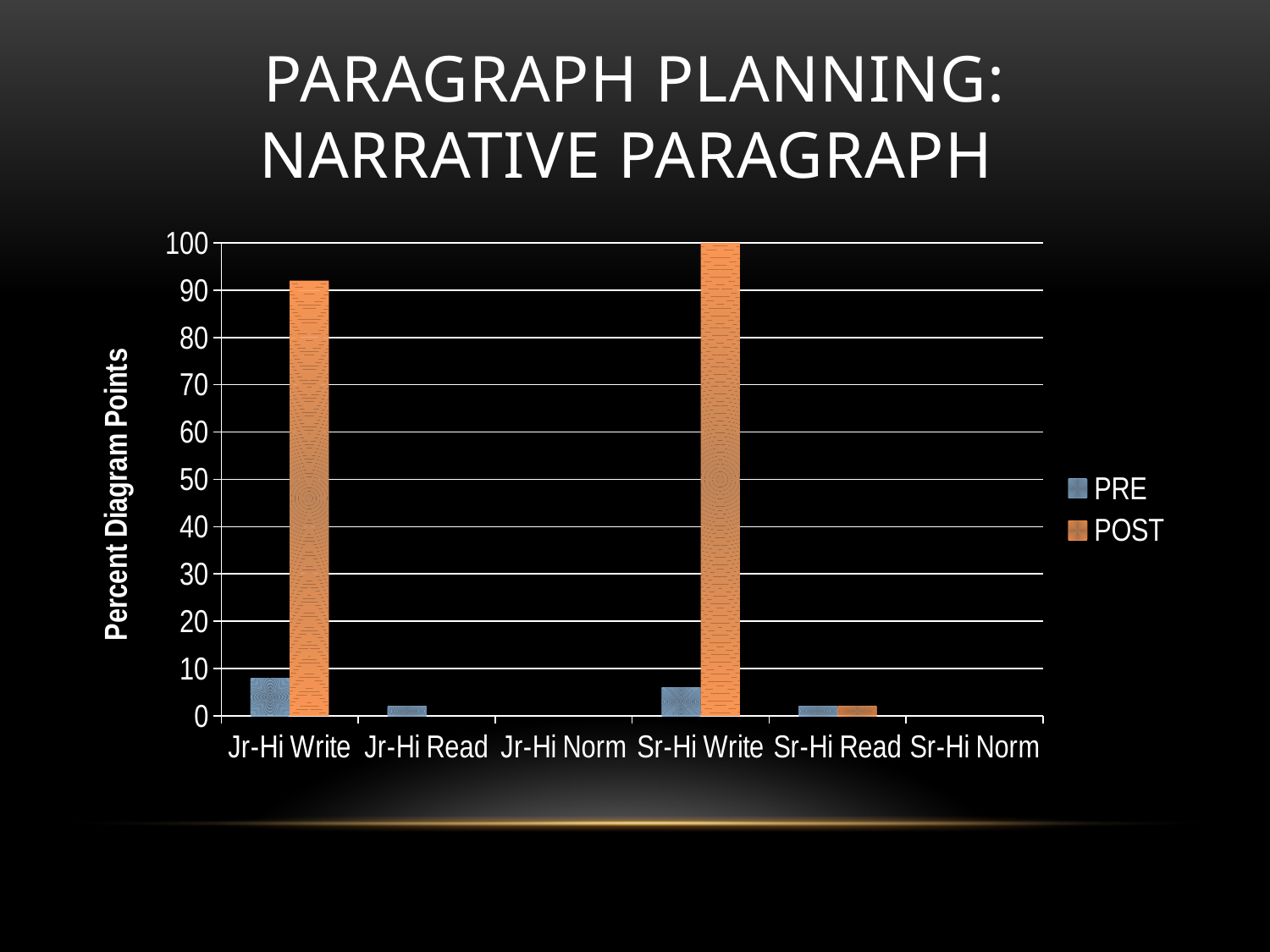
How many categories are shown on the x axis? 6 Which category has the highest POST value? Sr-Hi Write Which colour represents the POST series in the legend? orange Is the PRE value for Sr-Hi Write greater or less than 10? less What is the POST value for Sr-Hi Write? 100 Which is larger, the PRE value for Jr-Hi Write or the PRE value for Jr-Hi Read? Jr-Hi Write What kind of chart is shown on the slide? bar chart What is the label of the y axis? Percent Diagram Points Is the PRE value for Jr-Hi Write greater or less than 20? less Which is larger, the POST value for Jr-Hi Write or the POST value for Sr-Hi Write? Sr-Hi Write How many series does the legend list? 2 Is the POST value for Jr-Hi Write greater or less than 90? greater